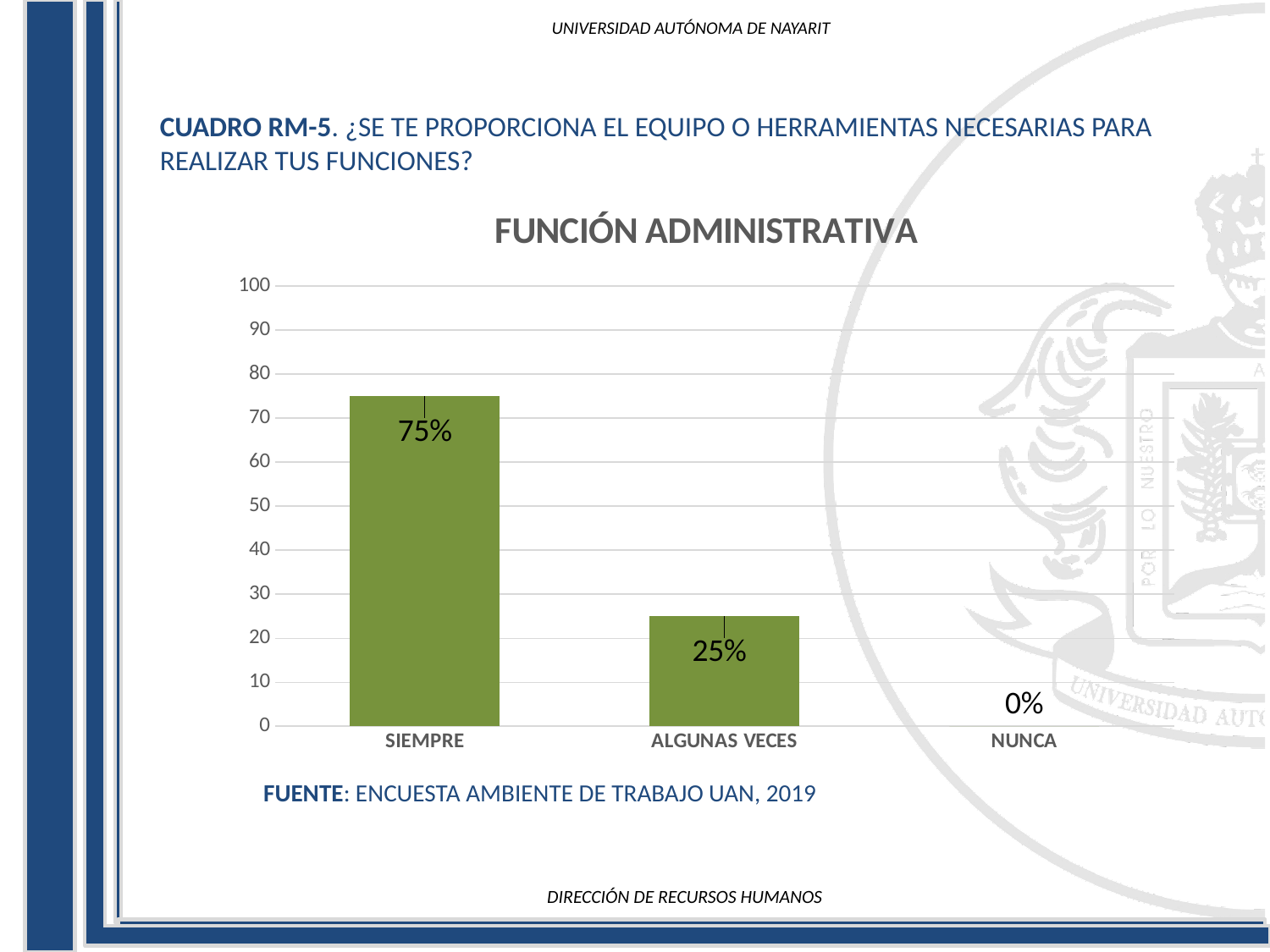
What is the value for NUNCA? 0% Which is larger, the value for ALGUNAS VECES or the value for NUNCA? ALGUNAS VECES Which category has the highest value? SIEMPRE What is the value for SIEMPRE? 75% Is the value for SIEMPRE greater or less than 50? greater Do the values rise or fall from left to right along the x axis? fall Which category has the lowest value? NUNCA What is the title of the chart? FUNCIÓN ADMINISTRATIVA What is the value for ALGUNAS VECES? 25% What kind of chart is shown on the slide? bar chart What is the difference between the values for SIEMPRE and ALGUNAS VECES? 50% How many categories are shown on the x axis? 3